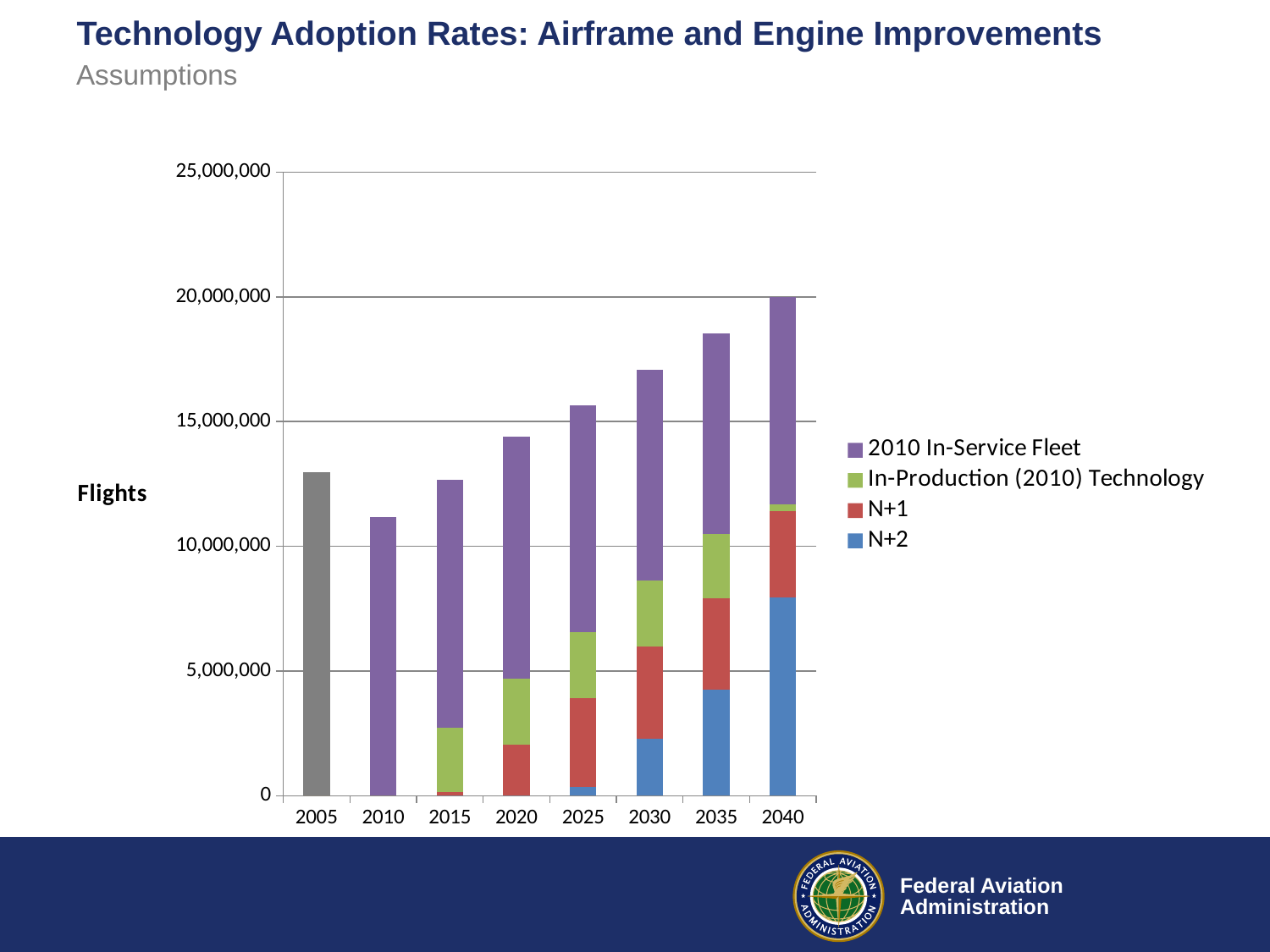
Which year has the shortest total bar? 2010 What kind of chart is shown on the slide? Stacked bar chart Which year has a larger total bar, 2030 or 2035? 2035 Which year has the tallest total bar? 2040 How many years are shown along the x axis of the chart? 8 What label is shown on the vertical axis of the chart? Flights Is the total bar for 2030 greater or less than 15,000,000? greater Is the total bar for 2005 greater or less than 10,000,000? greater Do the total bars rise or fall from 2010 to 2040? rise Is the total bar for 2035 greater or less than 20,000,000? less How many series does the chart's legend list? 4